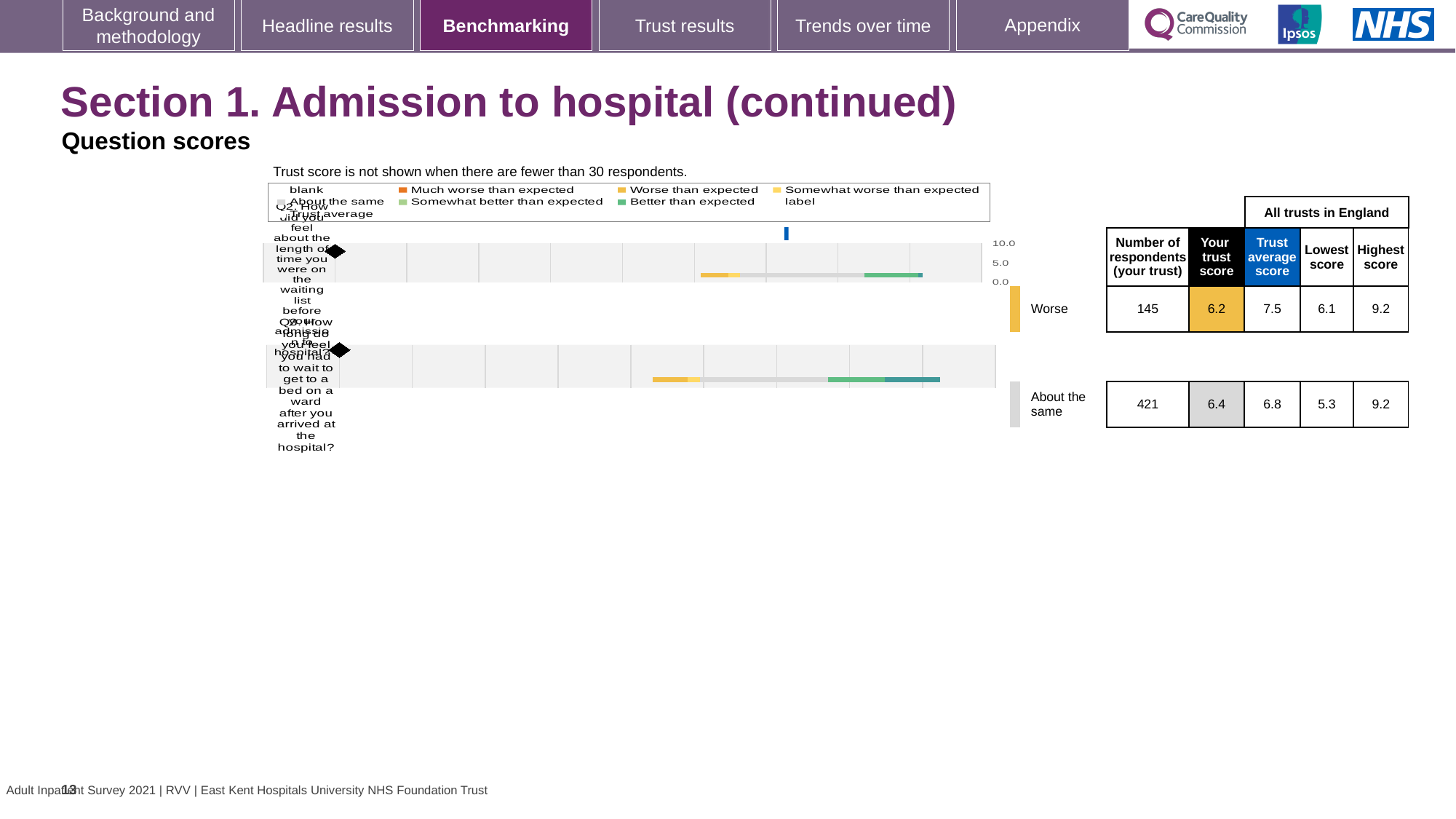
What is the difference between the trust average score and this trust's score for Q2? 1.3 What is the trust score for Q3 (how long did you feel you had to wait to get to a bed on a ward)? 6.4 What is the lowest score across all trusts in England for Q2? 6.1 Which is larger for Q3: this trust's score or the trust average score? Trust average score What kind of chart is used to show the Q2 and Q3 question scores on this slide? bar chart What is the maximum value shown on the score axis of the Q2 chart? 10.0 What is the trust average score for Q2? 7.5 How many respondents answered Q3 at this trust? 421 What is the benchmark category shown for Q2? Worse How many questions (Q2 and Q3) are plotted on this slide? 2 What is the highest score across all trusts in England for Q3? 9.2 What is the trust score for Q2 (how did you feel about the length of time on the waiting list before admission)? 6.2